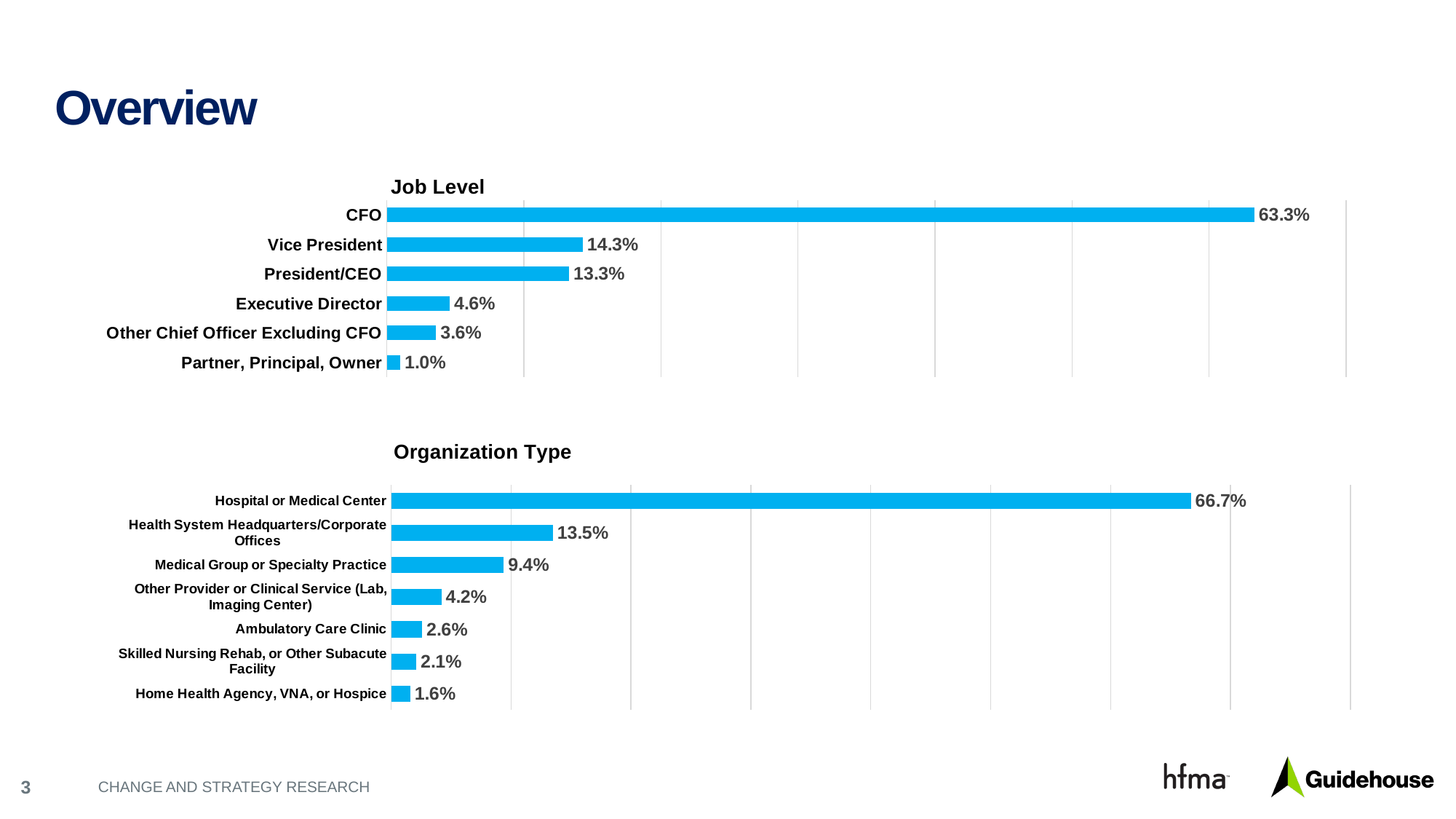
In the Organization Type chart, what is the value for Hospital or Medical Center? 66.7% In the Organization Type chart, how many organization types are listed? 7 In the Organization Type chart, what is the difference between Health System Headquarters/Corporate Offices and Medical Group or Specialty Practice? 4.1% In the Organization Type chart, which organization type has the highest percentage? Hospital or Medical Center In the Organization Type chart, what percentage is Medical Group or Specialty Practice? 9.4% In the Job Level chart, what is the difference between Vice President and President/CEO? 1.0% In the Organization Type chart, which is larger: Ambulatory Care Clinic or Skilled Nursing Rehab, or Other Subacute Facility? Ambulatory Care Clinic In the Job Level chart, which job level has the lowest percentage? Partner, Principal, Owner In the Job Level chart, how many job level categories are shown? 6 What type of chart is the Job Level chart? Bar chart In the Job Level chart, what is the value for Executive Director? 4.6% In the Job Level chart, what percentage of respondents are CFOs? 63.3%